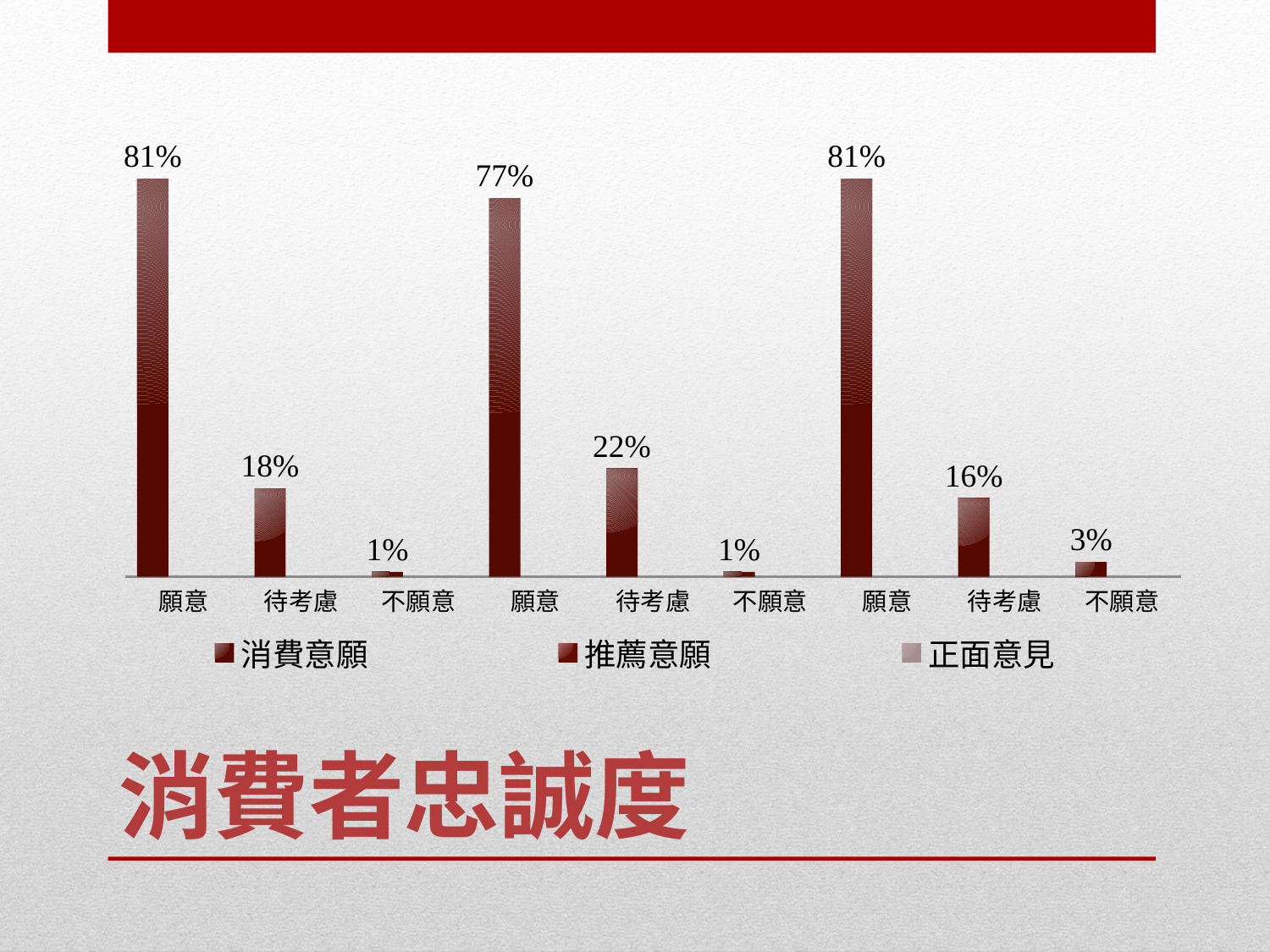
Which category has the lowest value in the 消費意願 series? 不願意 How many series does the legend list? 3 Which category has the highest value in the 正面意見 series? 願意 What kind of chart is shown on the slide? Bar chart What is the title shown on the slide? 消費者忠誠度 Do the values fall or rise from 願意 to 不願意 within the 推薦意願 series? Fall